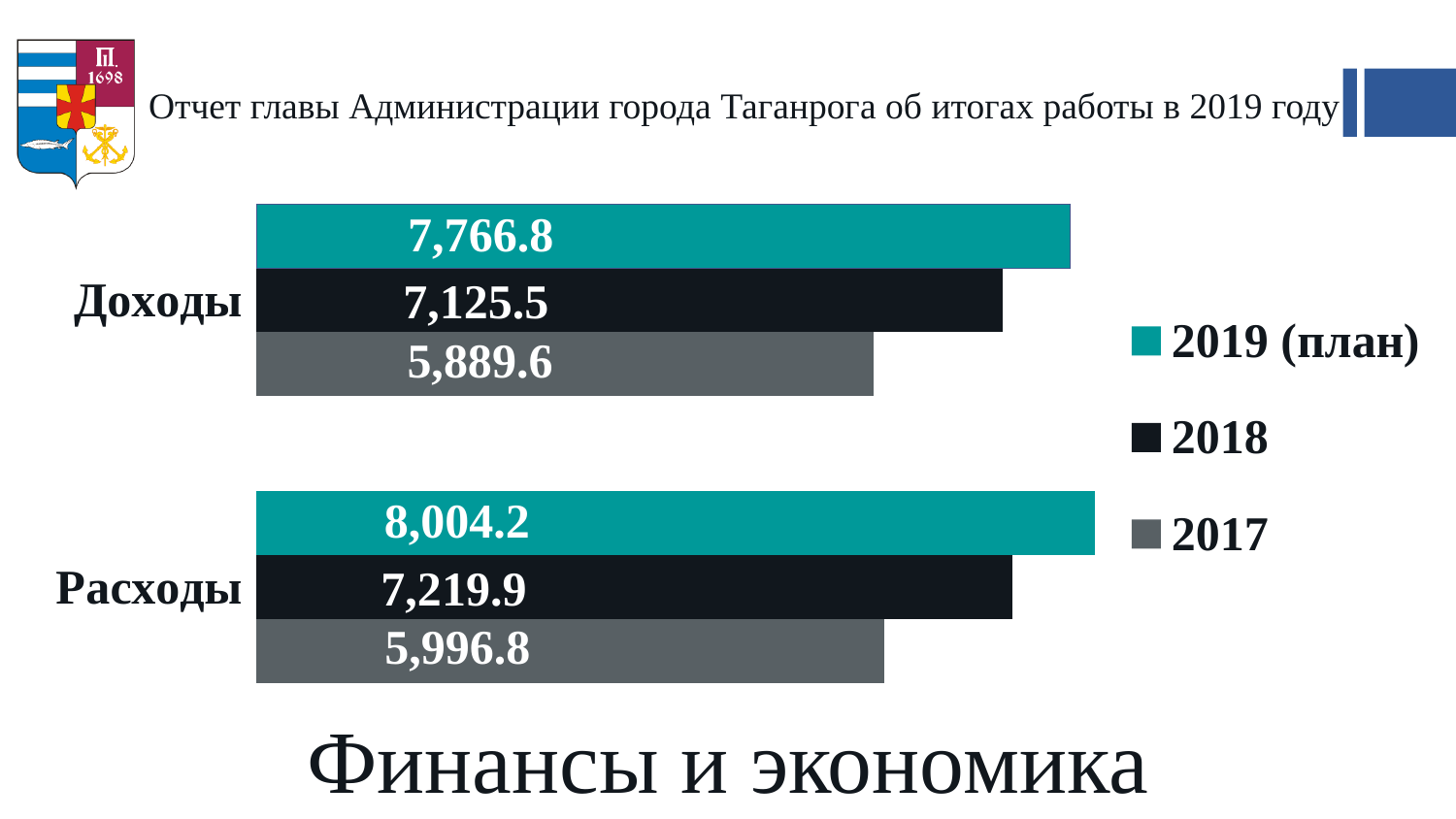
What is the value for Расходы in 2018? 7,219.9 Which series has the lowest value for Доходы? 2017 What kind of chart is shown on the slide? Bar chart Which series has the highest value for Расходы? 2019 (план) What is the difference between the 2019 (план) and 2017 values for Расходы? 2,007.4 What is the difference between the 2019 (план) and 2018 values for Доходы? 641.3 How many categories are shown on the chart? 2 What is the value for Доходы in the 2019 (план) series? 7,766.8 How many series does the legend list? 3 What is the value for Доходы in 2018? 7,125.5 What is the value for Расходы in the 2017 series? 5,996.8 Which is larger in 2018: Доходы or Расходы? Расходы